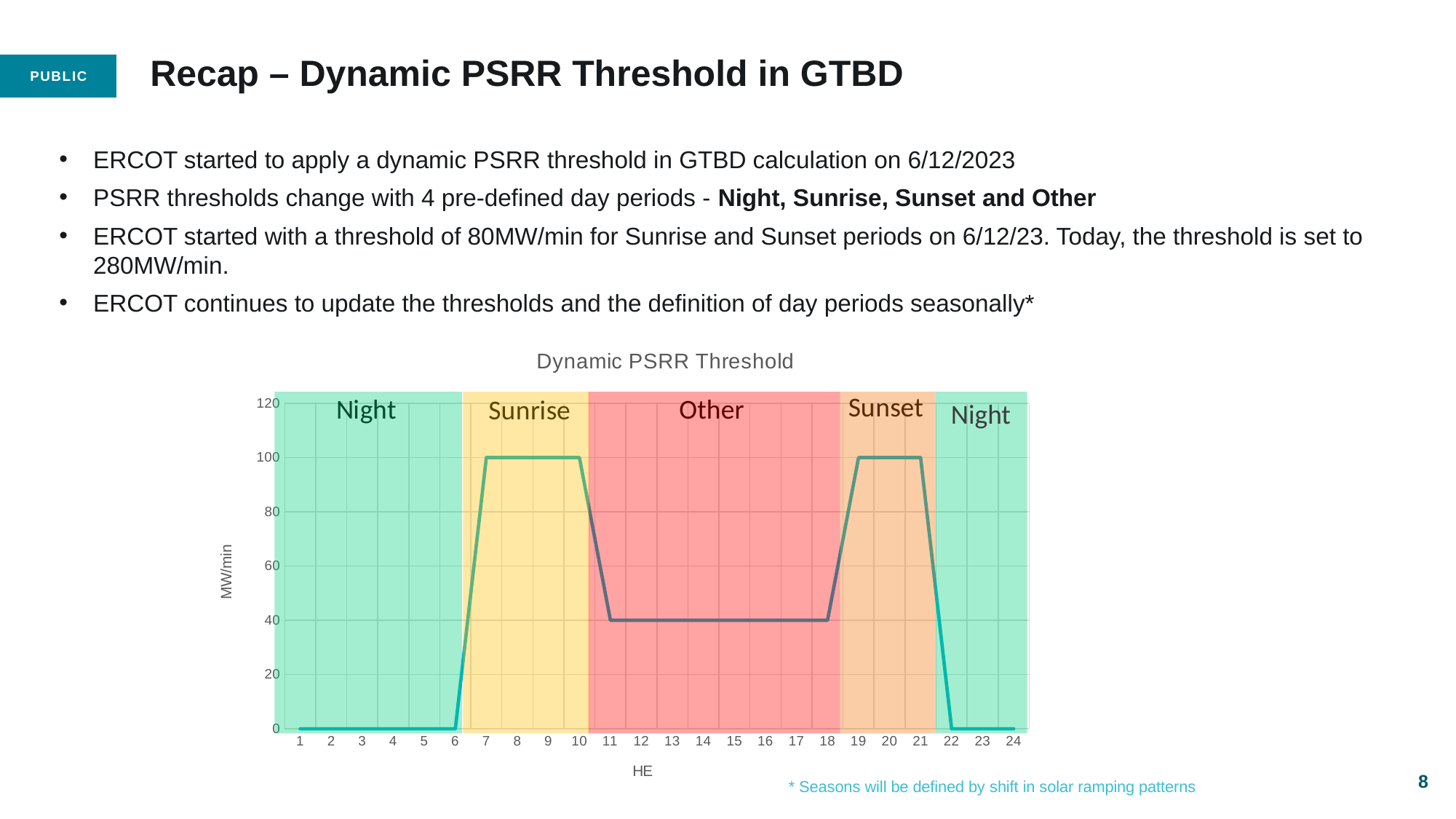
What is the value at HE 20? 100 How many hour-ending points are shown on the x axis? 24 What is the value at HE 14? 40 What is the value at HE 3? 0 What is the title of the chart? Dynamic PSRR Threshold Which is larger, the value at HE 12 or the value at HE 19? HE 19 Does the value rise or fall from HE 10 to HE 11? fall What is the value at HE 8? 100 What type of chart is shown on the slide? line chart What is the y-axis label of the chart? MW/min Is the value at HE 16 greater or less than 60? less What is the difference between the value at HE 9 and the value at HE 15? 60